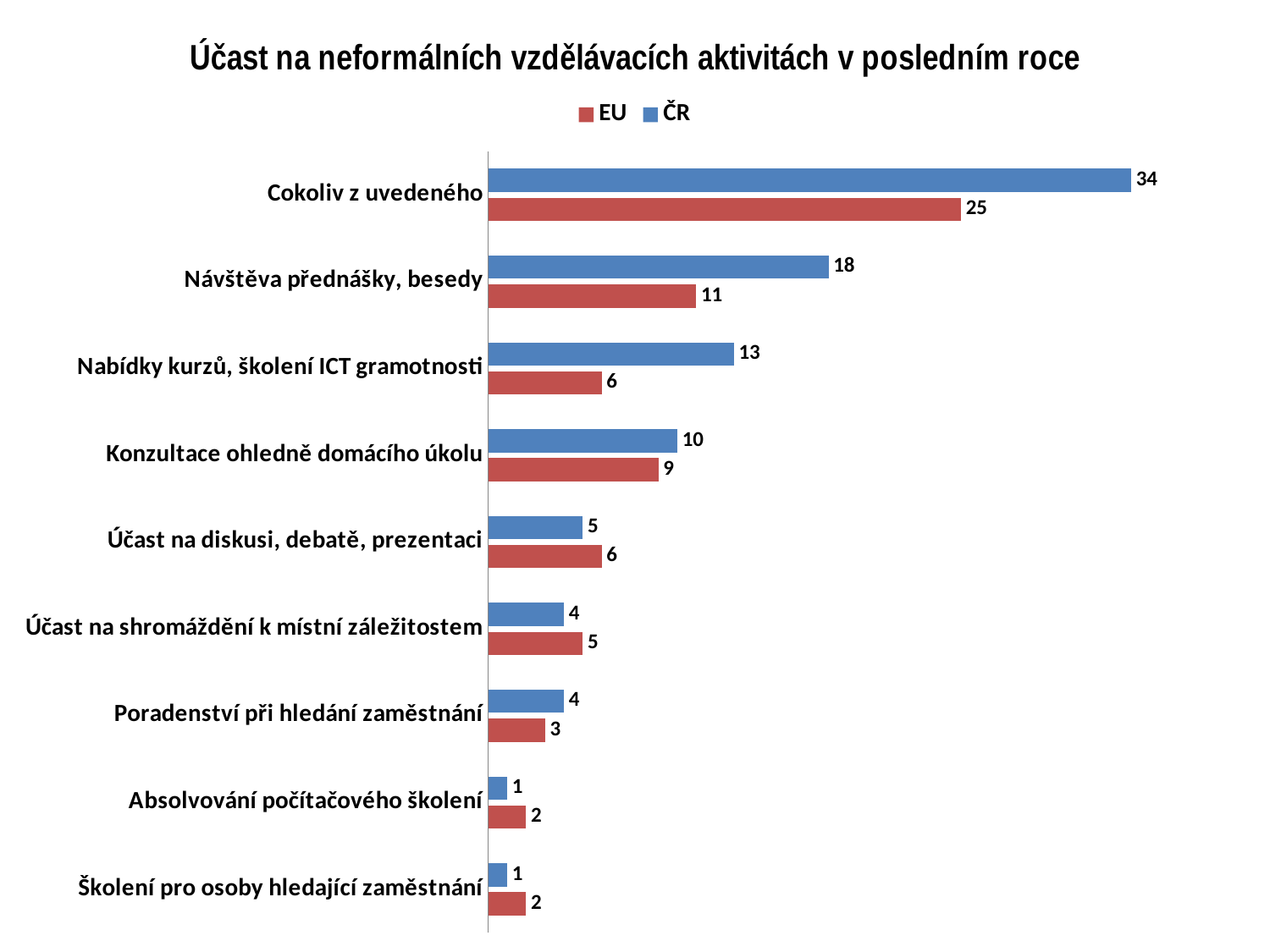
How many categories are shown on the chart? 9 What is the difference between the ČR and EU values for "Cokoliv z uvedeného"? 9 What is the EU value for "Návštěva přednášky, besedy"? 11 How many series does the legend list? 2 What is the difference between the ČR and EU values for "Návštěva přednášky, besedy"? 7 Which category has the highest EU value? Cokoliv z uvedeného What is the ČR value for "Cokoliv z uvedeného"? 34 Which category has the lowest ČR value? Absolvování počítačového školení and Školení pro osoby hledající zaměstnání (both 1) What is the ČR value for "Nabídky kurzů, školení ICT gramotnosti"? 13 Which is larger for "Účast na diskusi, debatě, prezentaci": the EU value or the ČR value? EU What is the EU value for "Konzultace ohledně domácího úkolu"? 9 What kind of chart is shown on the slide? Bar chart